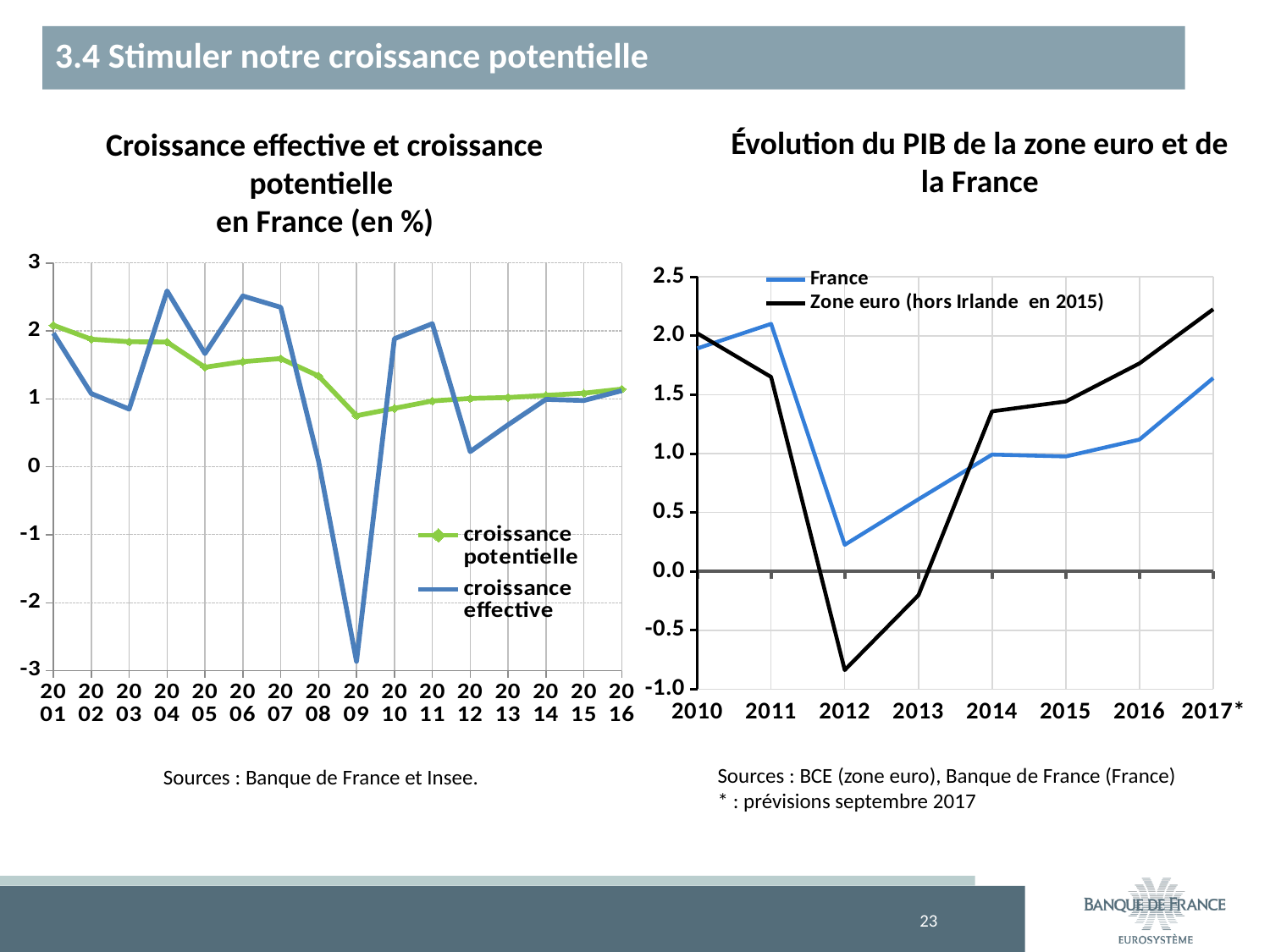
In the left chart, is the value of 'croissance effective' in 2009 greater or less than -2? less In the left chart, which series is higher in 2012, 'croissance potentielle' or 'croissance effective'? croissance potentielle In the right chart, what colour is the 'Zone euro (hors Irlande en 2015)' line? black In the right chart, 'Évolution du PIB de la zone euro et de la France', in which year is the 'Zone euro' series at its lowest? 2012 In the left chart, in which year is 'croissance effective' at its lowest? 2009 What kind of chart is the left chart, 'Croissance effective et croissance potentielle en France (en %)'? line chart How many series does the legend of the left chart list? 2 How many years are shown on the x axis of the left chart? 16 In the right chart, which series is higher in 2011, 'France' or 'Zone euro'? France In the left chart, is the value of 'croissance potentielle' in 2009 greater or less than 1? less In the right chart, does the 'France' series rise or fall from 2012 to 2017*? rise In the right chart, is the value for 'Zone euro' in 2017* greater or less than 2.0? greater